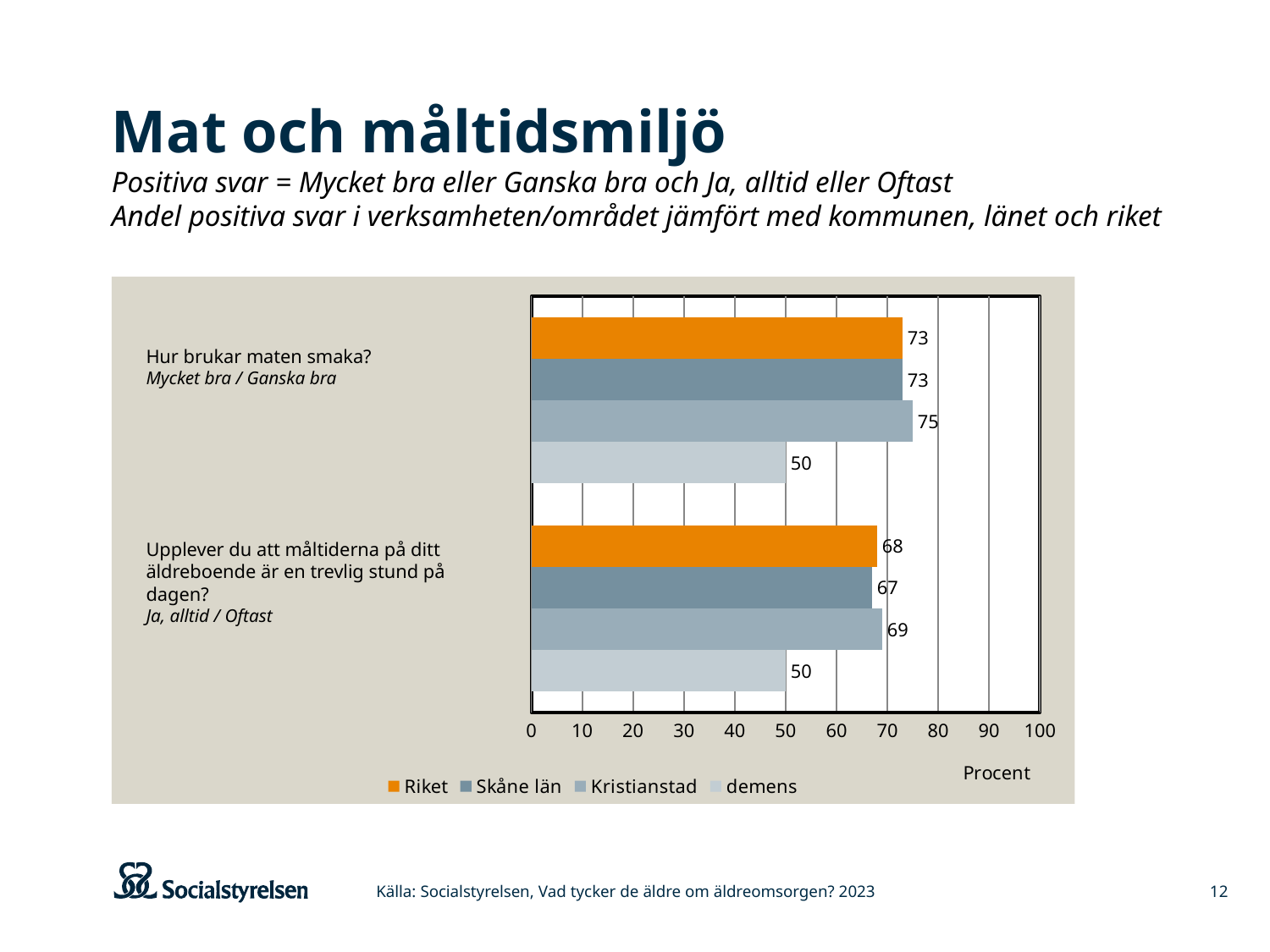
Which series has the highest value for "Upplever du att måltiderna på ditt äldreboende är en trevlig stund på dagen?"? Kristianstad What is the difference between the Kristianstad and demens values for "Hur brukar maten smaka?"? 25 What is the value for demens for "Upplever du att måltiderna på ditt äldreboende är en trevlig stund på dagen?"? 50 What is the value for Riket for "Upplever du att måltiderna på ditt äldreboende är en trevlig stund på dagen?"? 68 What kind of chart is shown on the slide? Bar chart What is the label of the x axis? Procent Which series has the lowest value for "Hur brukar maten smaka?"? demens What is the value for Skåne län for "Hur brukar maten smaka?"? 73 How many question categories are shown on the chart? 2 What is the value for Kristianstad for "Hur brukar maten smaka?"? 75 How many series does the legend list? 4 Which is larger for "Upplever du att måltiderna på ditt äldreboende är en trevlig stund på dagen?": Riket or demens? Riket